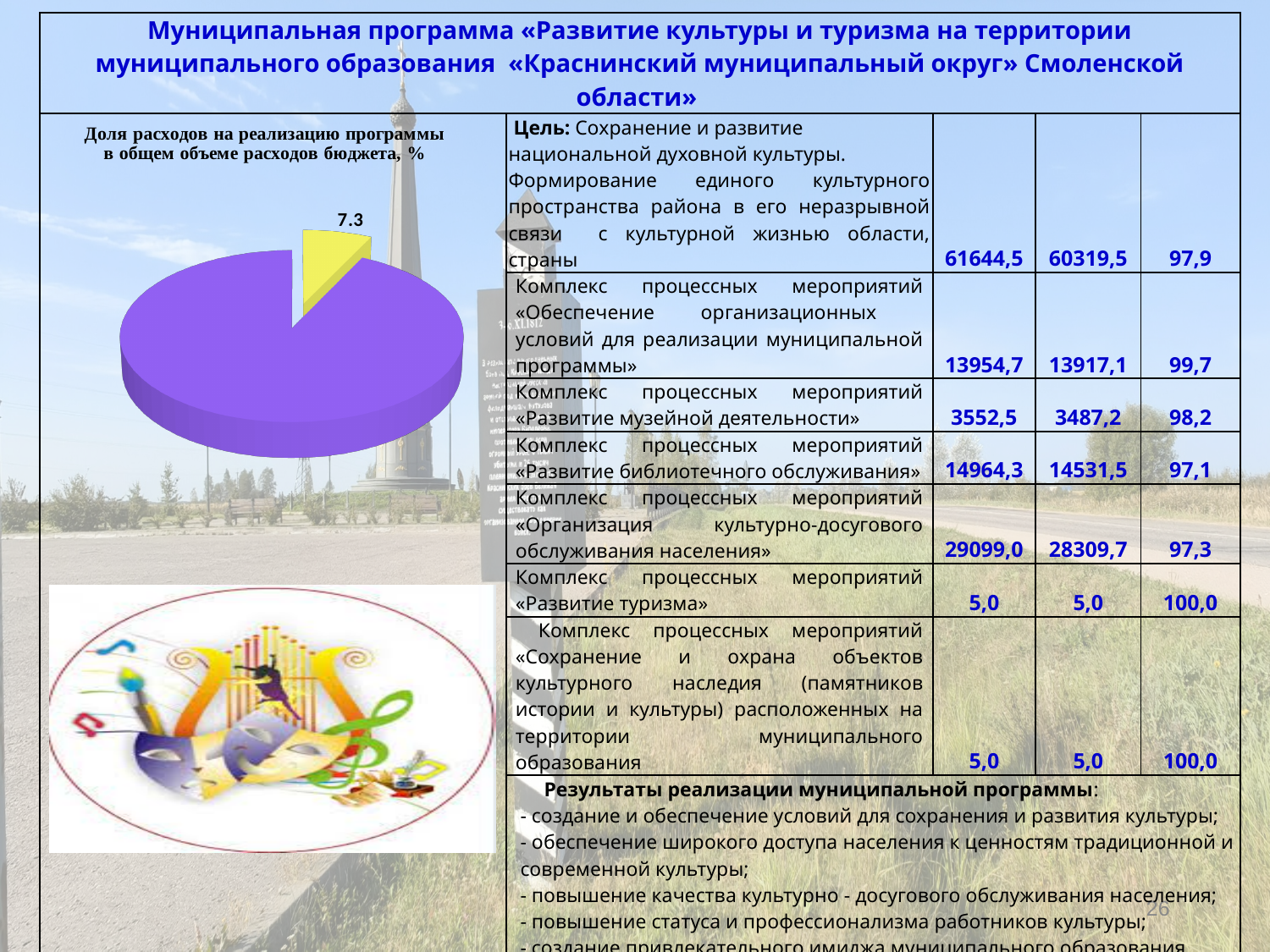
What is the title of the pie chart? Доля расходов на реализацию программы в общем объеме расходов бюджета, % Is the value of the yellow slice in the pie chart greater or less than 10? less How many slices does the pie chart have? 2 What colour is the slice labelled 7.3 in the pie chart? yellow What kind of chart is shown on the left of the slide? pie chart What value is printed on the labelled slice of the pie chart? 7.3 Which slice of the pie chart is larger, the purple one or the yellow one? the purple one